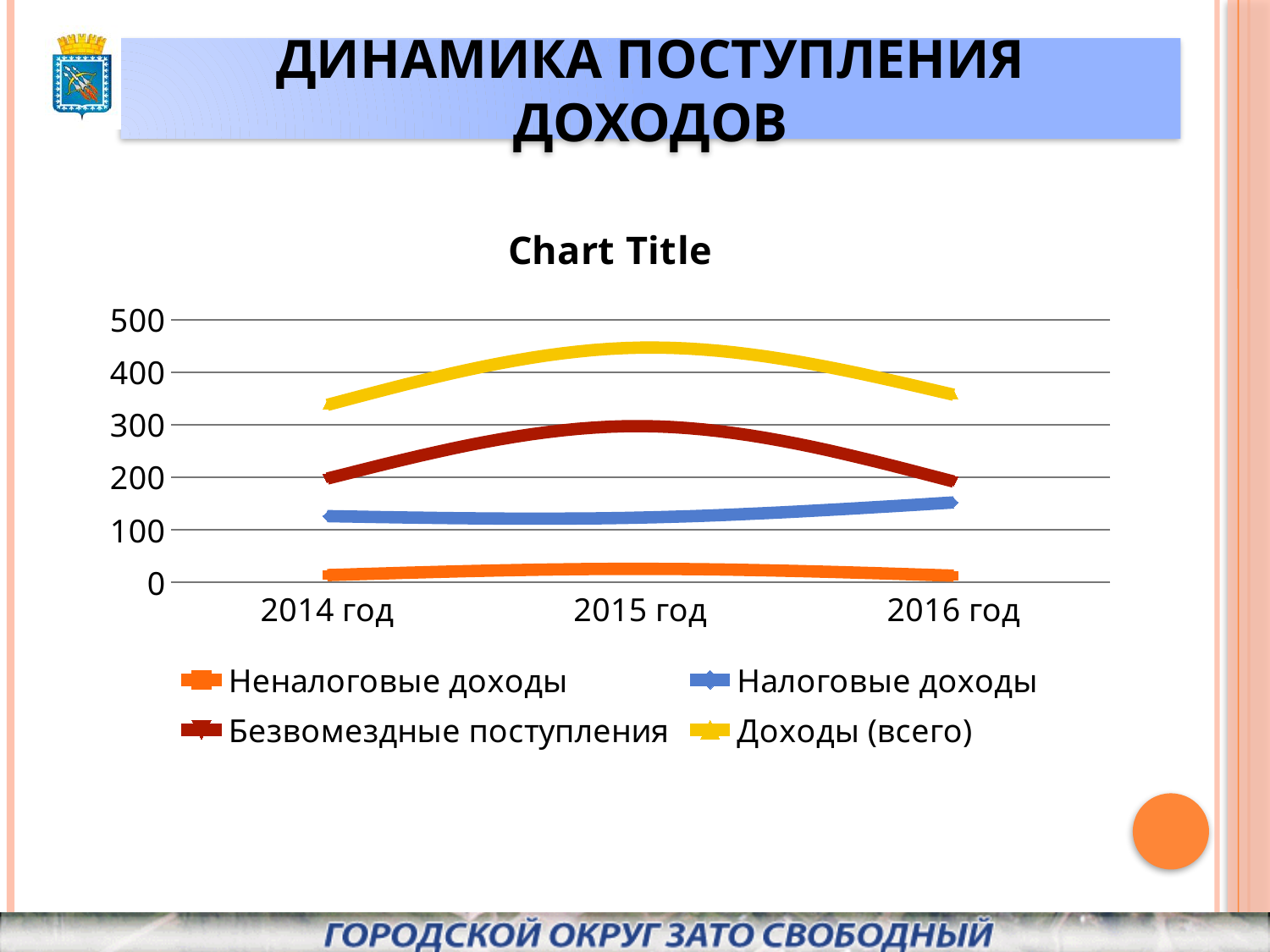
Is the value for Налоговые доходы in 2014 год greater or less than 200? less In which year is the value for Доходы (всего) highest? 2015 год What is the title shown above the chart? Chart Title What kind of chart is shown on the slide? line chart Which series has the lowest values across all years? Неналоговые доходы Does the value for Доходы (всего) rise or fall from 2015 год to 2016 год? fall How many series does the legend list? 4 Is the value for Доходы (всего) in 2015 год greater or less than 400? greater How many years are shown on the x axis? 3 In 2015 год, which is larger: Безвозмездные поступления or Налоговые доходы? Безвозмездные поступления Is the value for Безвозмездные поступления in 2015 год greater or less than 200? greater